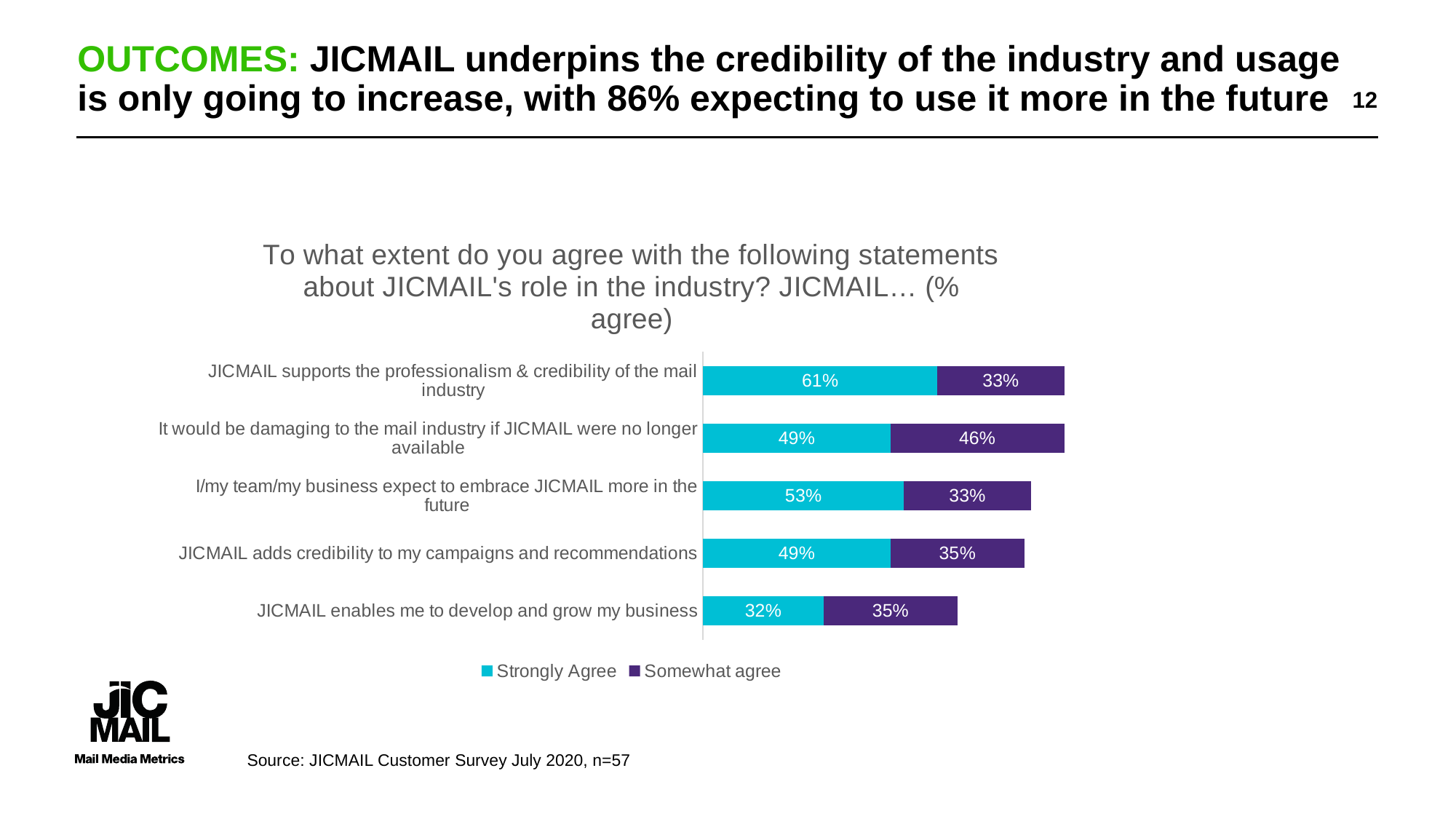
How many series does the legend list? 2 Which statement has the lowest Strongly Agree value? JICMAIL enables me to develop and grow my business What kind of chart is shown on the slide? Stacked bar chart What is the difference between the Strongly Agree values for 'JICMAIL supports the professionalism & credibility of the mail industry' and 'JICMAIL enables me to develop and grow my business'? 29% What is the Strongly Agree value for 'JICMAIL supports the professionalism & credibility of the mail industry'? 61% What is the total of the stacked bar for 'I/my team/my business expect to embrace JICMAIL more in the future'? 86% What is the Somewhat agree value for 'It would be damaging to the mail industry if JICMAIL were no longer available'? 46% Which statement has the highest Strongly Agree value? JICMAIL supports the professionalism & credibility of the mail industry What is the Strongly Agree value for 'JICMAIL enables me to develop and grow my business'? 32% What is the Somewhat agree value for 'JICMAIL adds credibility to my campaigns and recommendations'? 35% Which is larger: the Somewhat agree value for 'It would be damaging to the mail industry if JICMAIL were no longer available' or for 'JICMAIL supports the professionalism & credibility of the mail industry'? It would be damaging to the mail industry if JICMAIL were no longer available How many statements are shown in the chart? 5